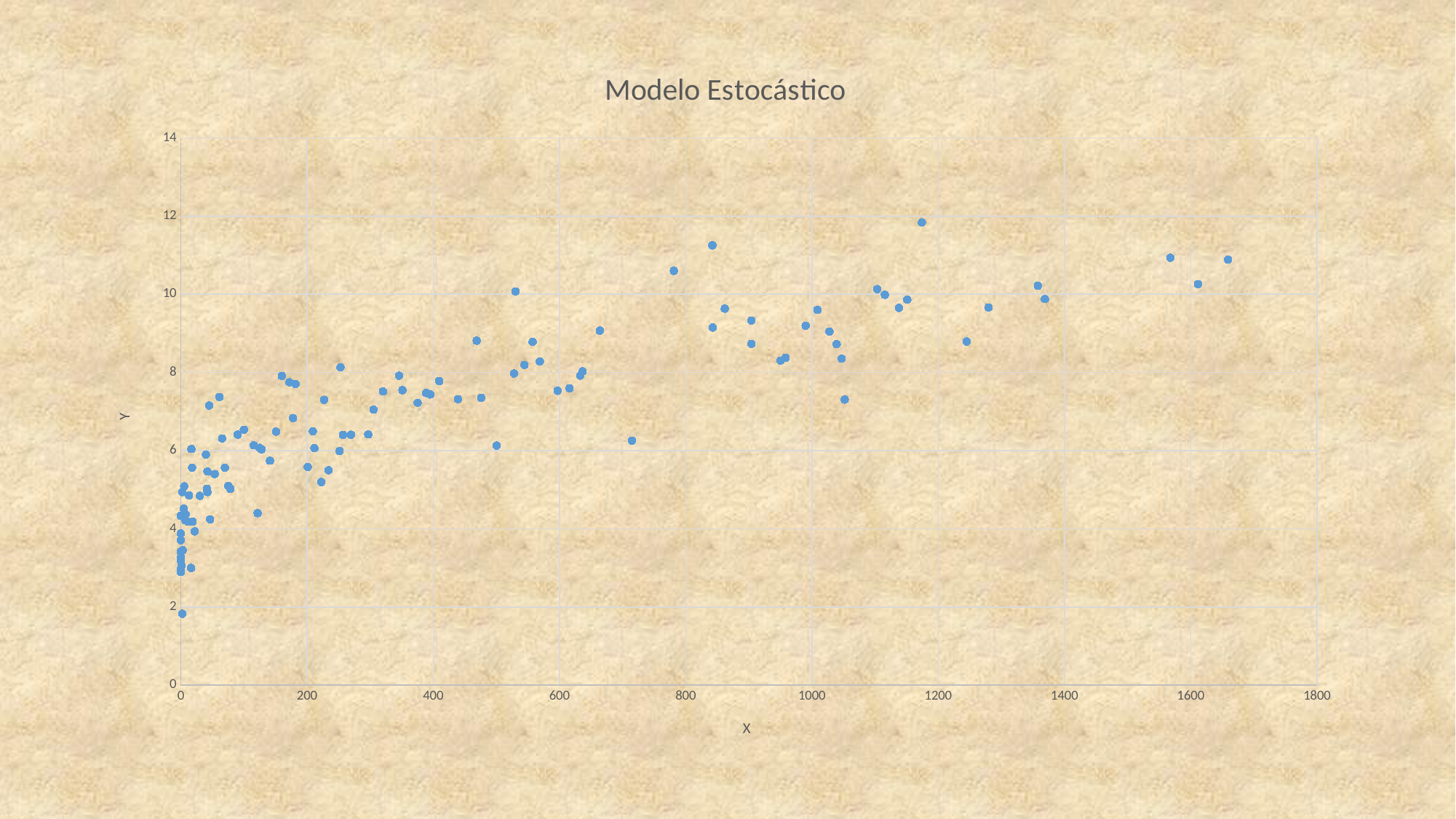
Is the lowest Y value plotted on the chart greater or less than 4? less Is the Y value of the point plotted near X = 1170 greater or less than 10? greater Is the Y value of the point with the largest X value greater or less than 10? greater What is the title of the chart? Modelo Estocástico Do the Y values generally rise or fall as X increases along the x axis? rise What kind of chart is shown on the slide? scatter plot Which has the larger Y value: the point with the largest X value or the point with the lowest Y value near X = 0? the point with the largest X value What is the label of the horizontal axis of the chart? X